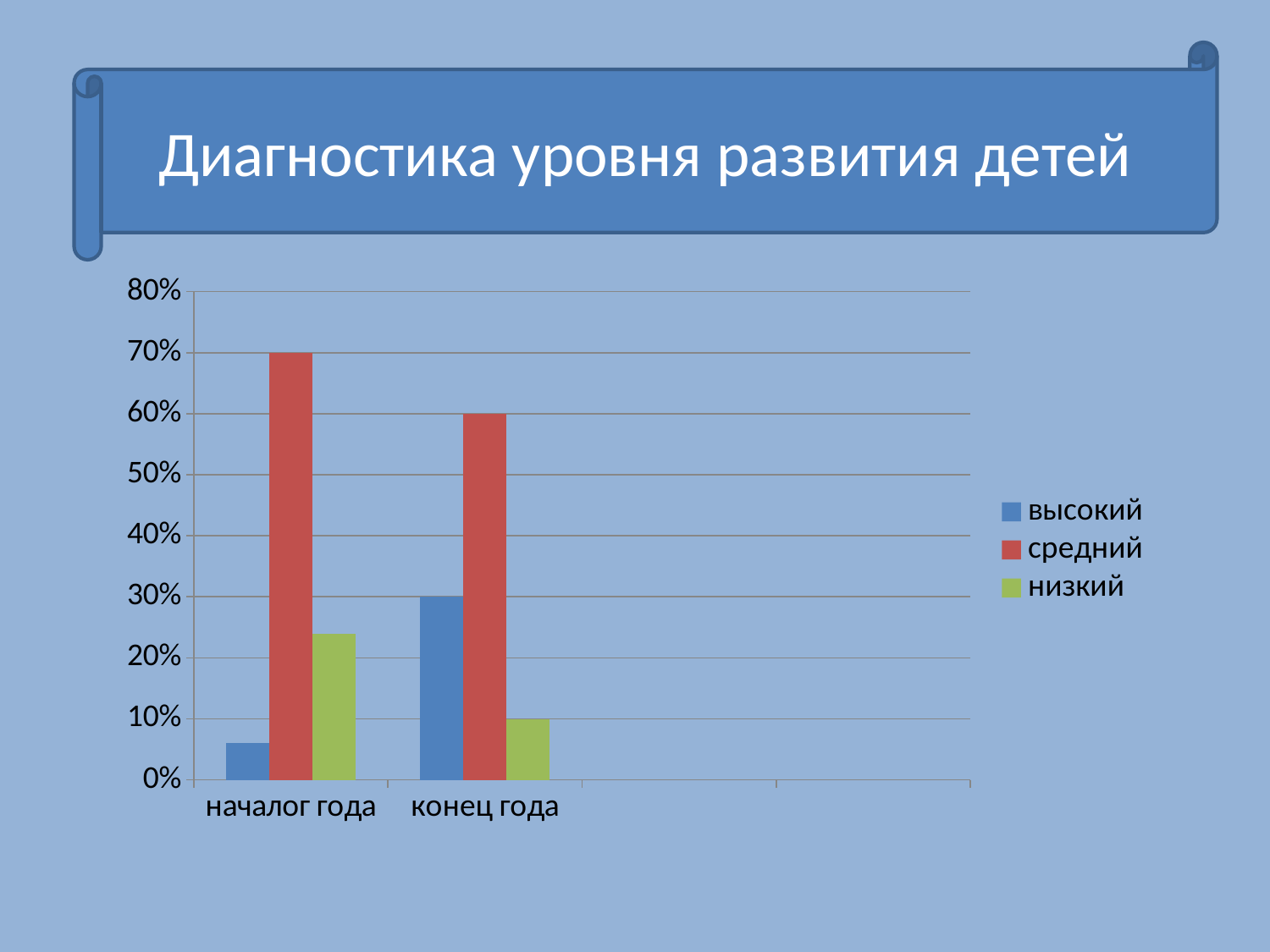
How many series does the legend list? 3 What is the value for низкий at конец года? 10% Which series has the highest value at конец года? средний How many categories are shown on the x axis? 2 What is the difference between the средний values at началог года and конец года? 10% What kind of chart is shown on the slide? bar chart Which is larger: высокий at началог года or высокий at конец года? высокий at конец года What is the value for средний at началог года? 70% What is the value for высокий at конец года? 30% Is the value for низкий at началог года greater or less than 20%? greater Is the value for высокий at началог года greater or less than 10%? less What is the value for средний at конец года? 60%